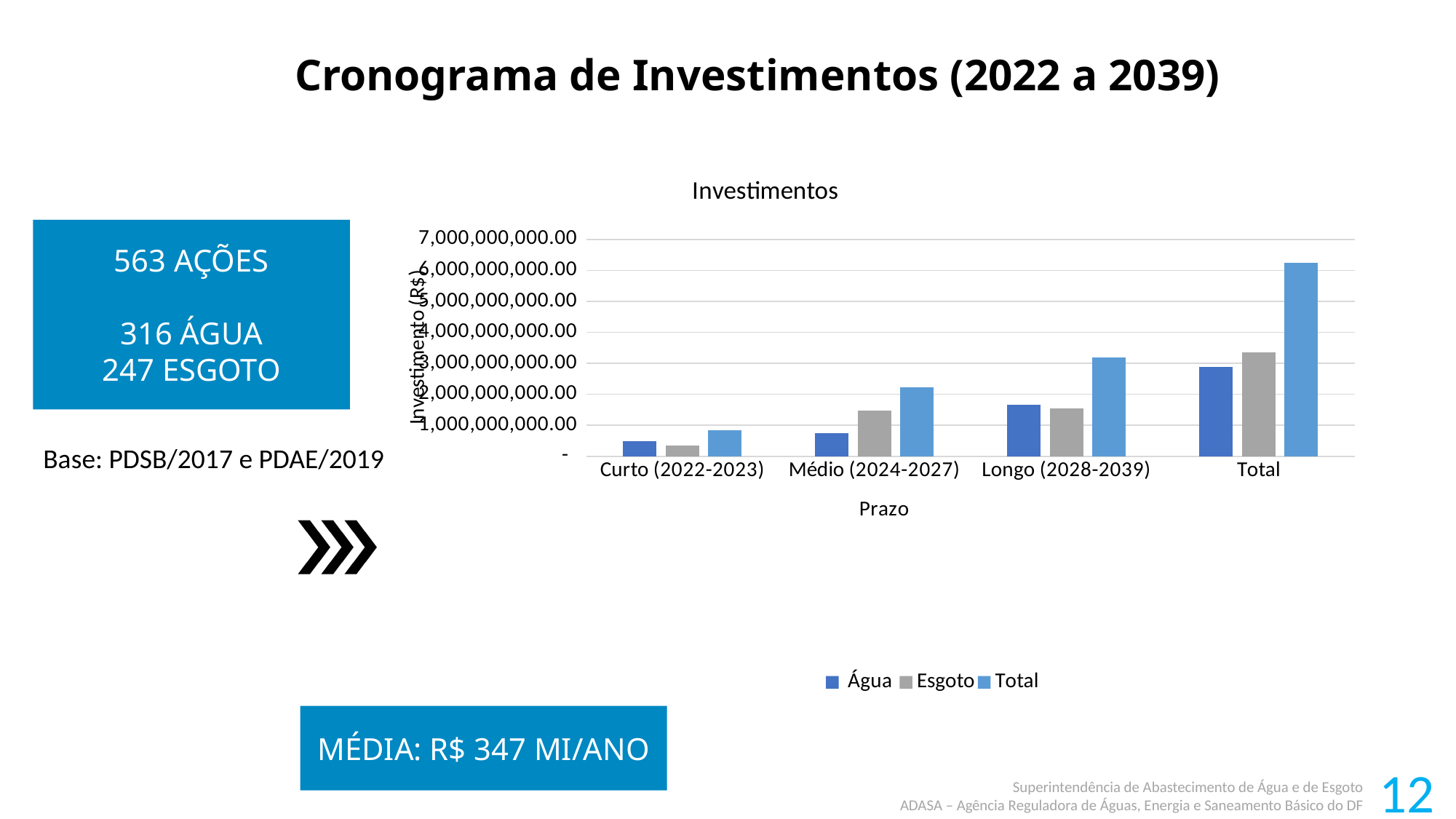
How many categories are shown on the x axis of the Investimentos chart? 4 How many series does the legend of the Investimentos chart list? 3 Do the values of the Total series rise or fall from Curto (2022-2023) to Total along the x axis? rise Is the Água value for Médio (2024-2027) greater or less than 1,000,000,000.00? less Is the Total series value for the Total category greater or less than 5,000,000,000.00? greater What kind of chart is shown on the slide? bar chart Is the Total series value for Curto (2022-2023) greater or less than 1,000,000,000.00? less What is the label of the y axis of the Investimentos chart? Investimento (R$) In the Médio (2024-2027) category, which is larger, the Água value or the Esgoto value? Esgoto Which category has the highest value for the Total series? Total Which category has the lowest value for the Esgoto series? Curto (2022-2023)